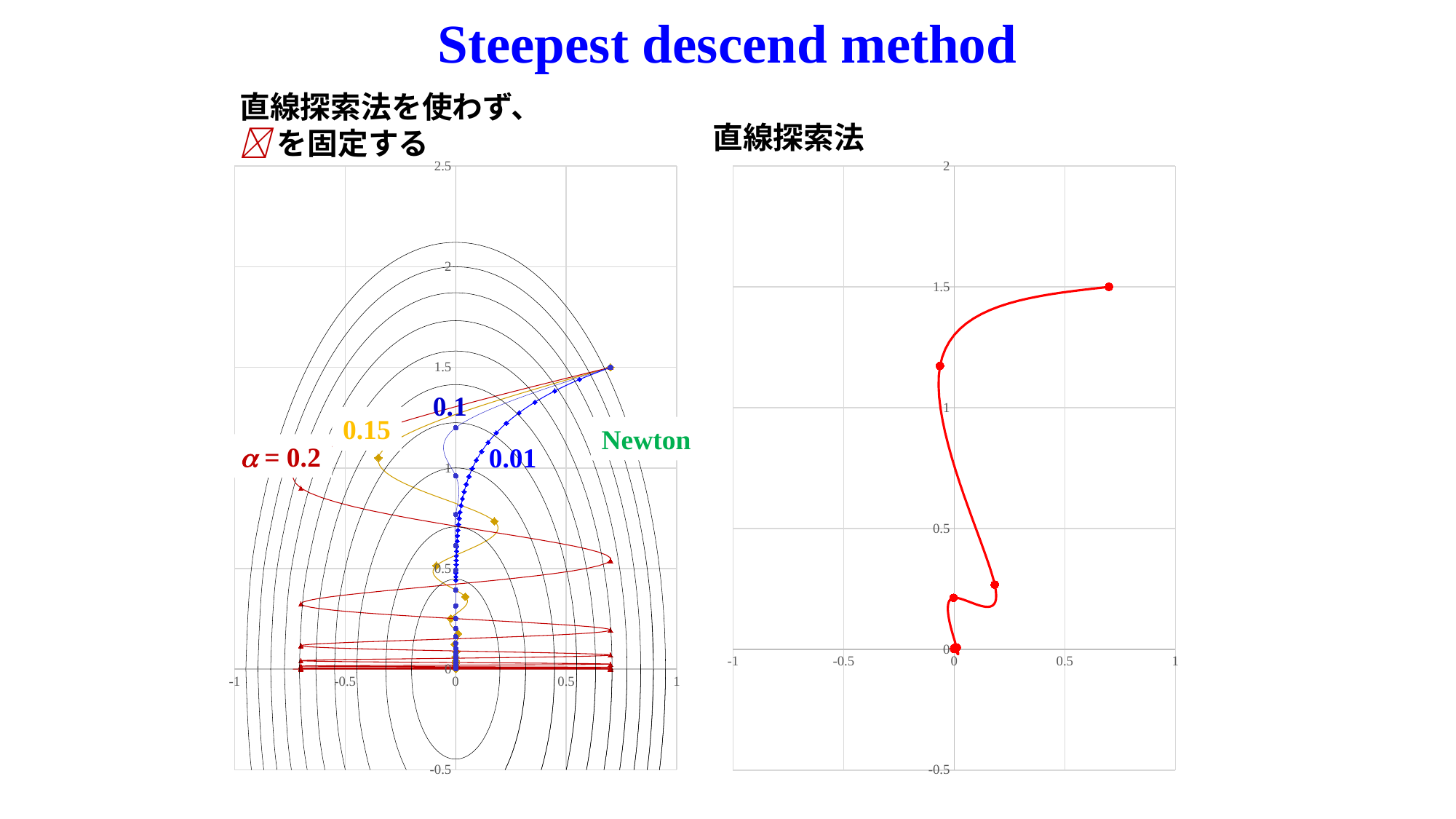
On the right chart (直線探索法), following the red path from the starting point at the top right to the end, do the y values generally rise or fall? fall On the right chart (直線探索法), is the y value of the starting point greater or less than 1? greater On the left chart, is the y value of the common starting point of the trajectories greater or less than 1? greater On the left chart, what kind of chart is used to show the optimization paths over the contour lines? line chart On the left chart, what colour is the label 'Newton'? green On the left chart, how many labeled trajectories are drawn (including Newton)? 5 On the left chart, which α value is labeled in red? 0.2 On the right chart (直線探索法), is the x value of the starting point at the top right greater or less than 0.5? greater What is the heading written above the right chart? 直線探索法 On the left chart, which α value's trajectory spans the widest range in x? 0.2